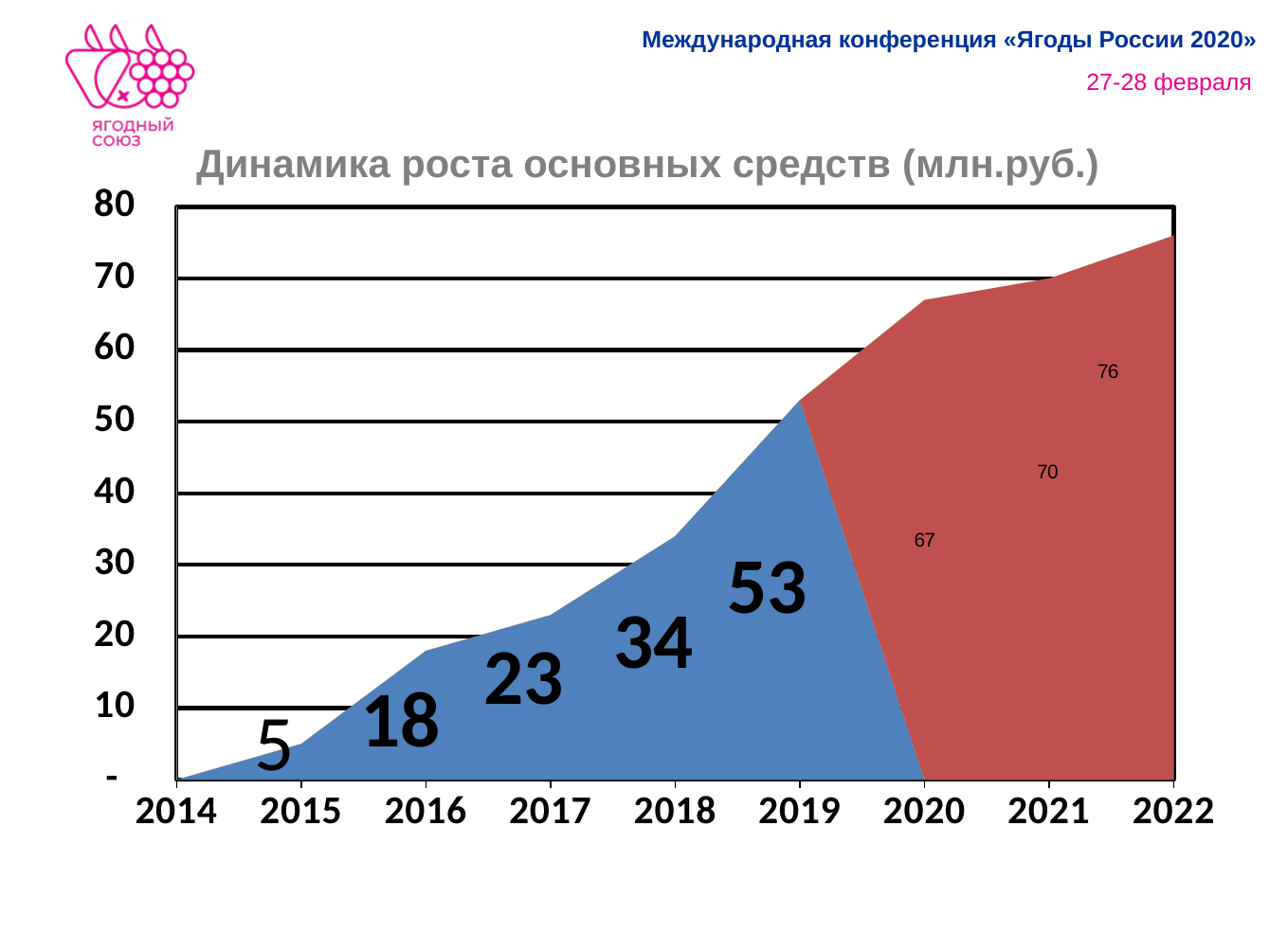
What kind of chart is this? area chart How many years are shown on the x axis? 9 What is the value for 2015? 5 What is the value for 2019? 53 Which is larger, the value for 2018 or the value for 2017? 2018 Which year has the highest value? 2022 Is the value for 2014 greater or less than 10? less What is the value for 2017? 23 What is the difference between the values for 2022 and 2016? 58 What is the value for 2021? 70 Do the values rise or fall from 2014 to 2022? rise What is the difference between the values for 2020 and 2019? 14